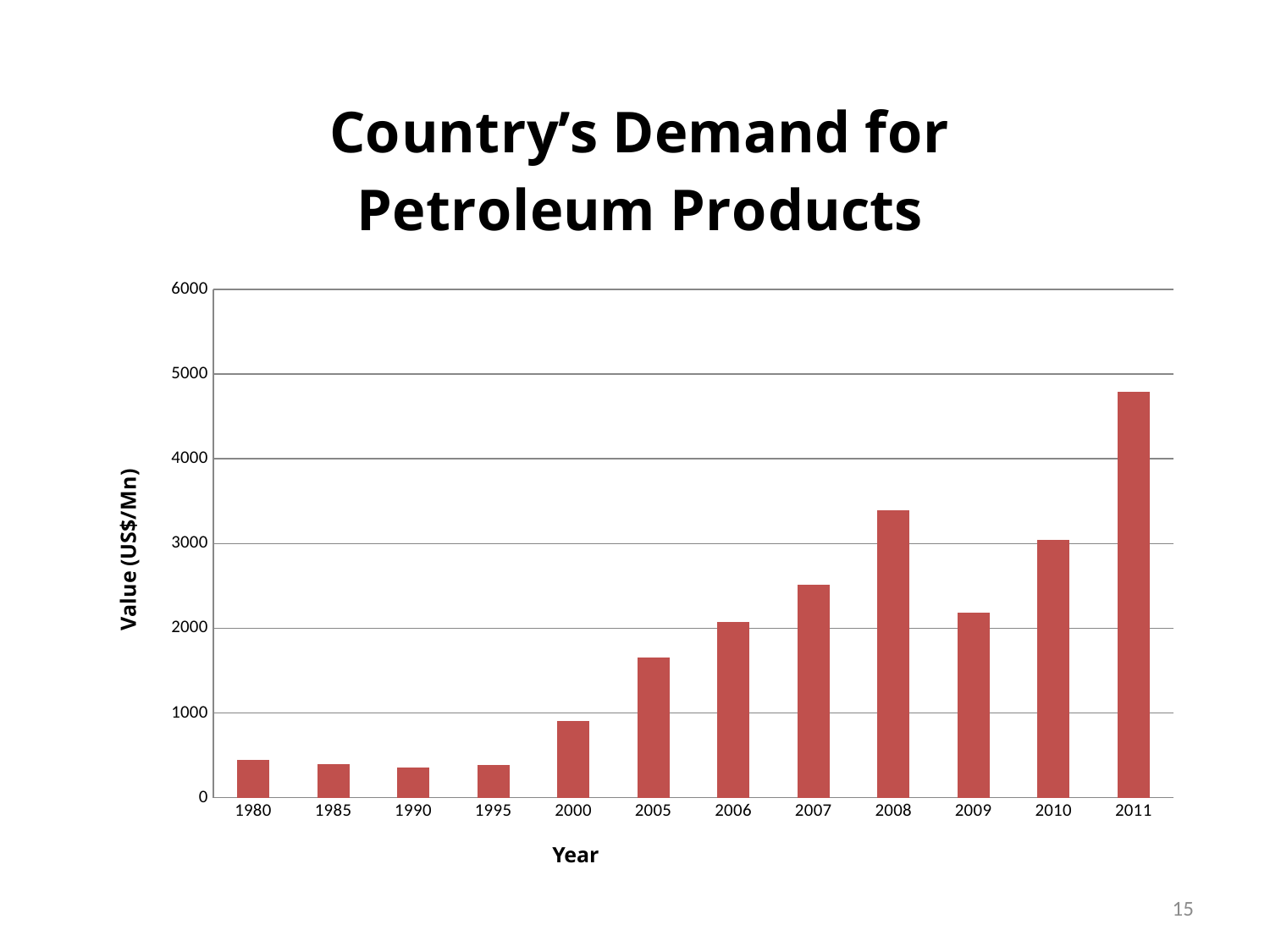
Do the values generally rise or fall from 1980 to 2011? rise Is the value for 2007 greater or less than 2000? greater What is the label on the vertical axis of the chart? Value (US$/Mn) Is the value for 2011 greater or less than 4000? greater Which year has the larger value, 2008 or 2009? 2008 Which year has the larger value, 1995 or 2000? 2000 Is the value for 2008 greater or less than 3000? greater Which year has the highest value for the country's demand for petroleum products? 2011 What kind of chart is shown on the slide? bar chart How many years are plotted on the x axis of the chart? 12